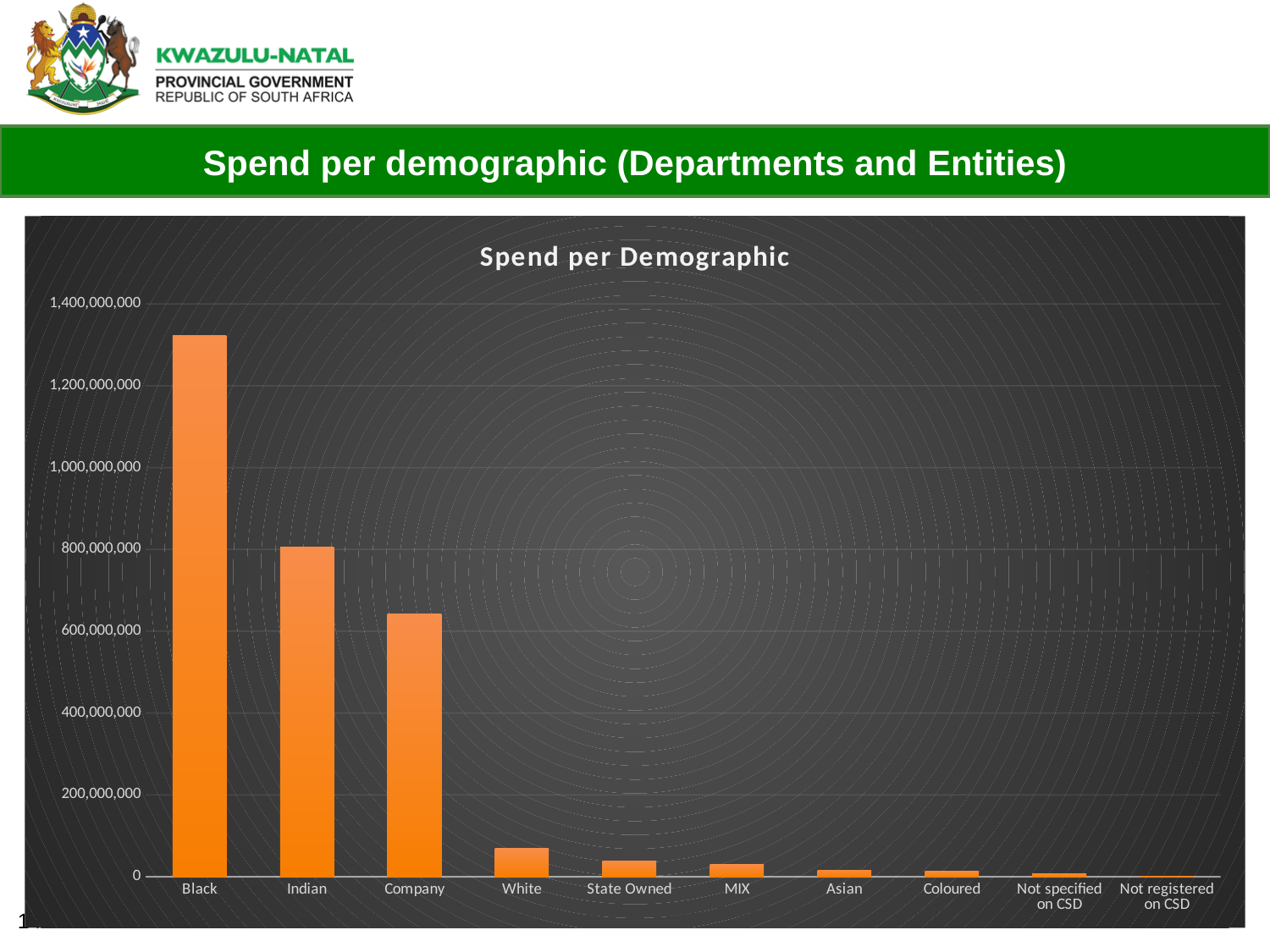
What kind of chart is shown on the slide? bar chart Which is larger, the spend for Indian or the spend for Company? Indian How many categories are shown on the x axis of the chart? 10 What colour are the bars in the chart? orange What is the title of the chart? Spend per Demographic Which category has the highest spend in the chart? Black Is the value for White greater or less than 200,000,000? less Do the values rise or fall moving from left to right along the x axis? fall Is the value for Company greater or less than 800,000,000? less Which is larger, the spend for Company or the spend for White? Company Is the value for Indian greater or less than 600,000,000? greater